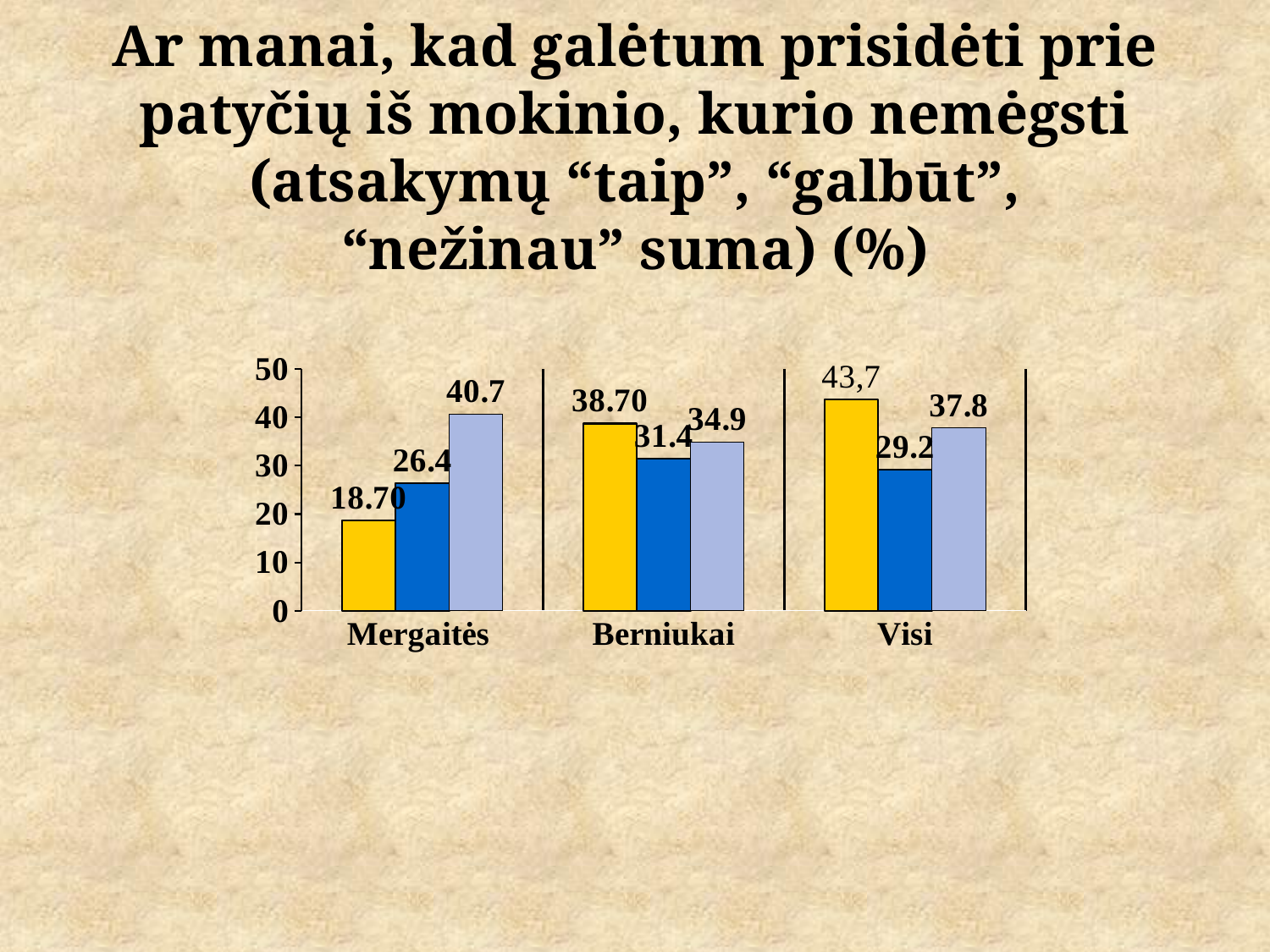
What is the value of the dark blue bar for Visi? 29.2 Which category has the lowest yellow bar? Mergaitės What is the highest value shown on the vertical axis? 50 What is the value of the yellow bar for Visi? 43,7 Which category has the highest yellow bar? Visi What is the value of the yellow bar for Mergaitės? 18.70 How many categories are shown on the x axis? 3 What is the difference between the light blue bar and the dark blue bar for Mergaitės? 14.3 What is the value of the yellow bar for Berniukai? 38.70 What is the value of the light blue (lavender) bar for Mergaitės? 40.7 What kind of chart is shown on the slide? bar chart Which is larger for Berniukai: the dark blue bar or the light blue bar? the light blue bar